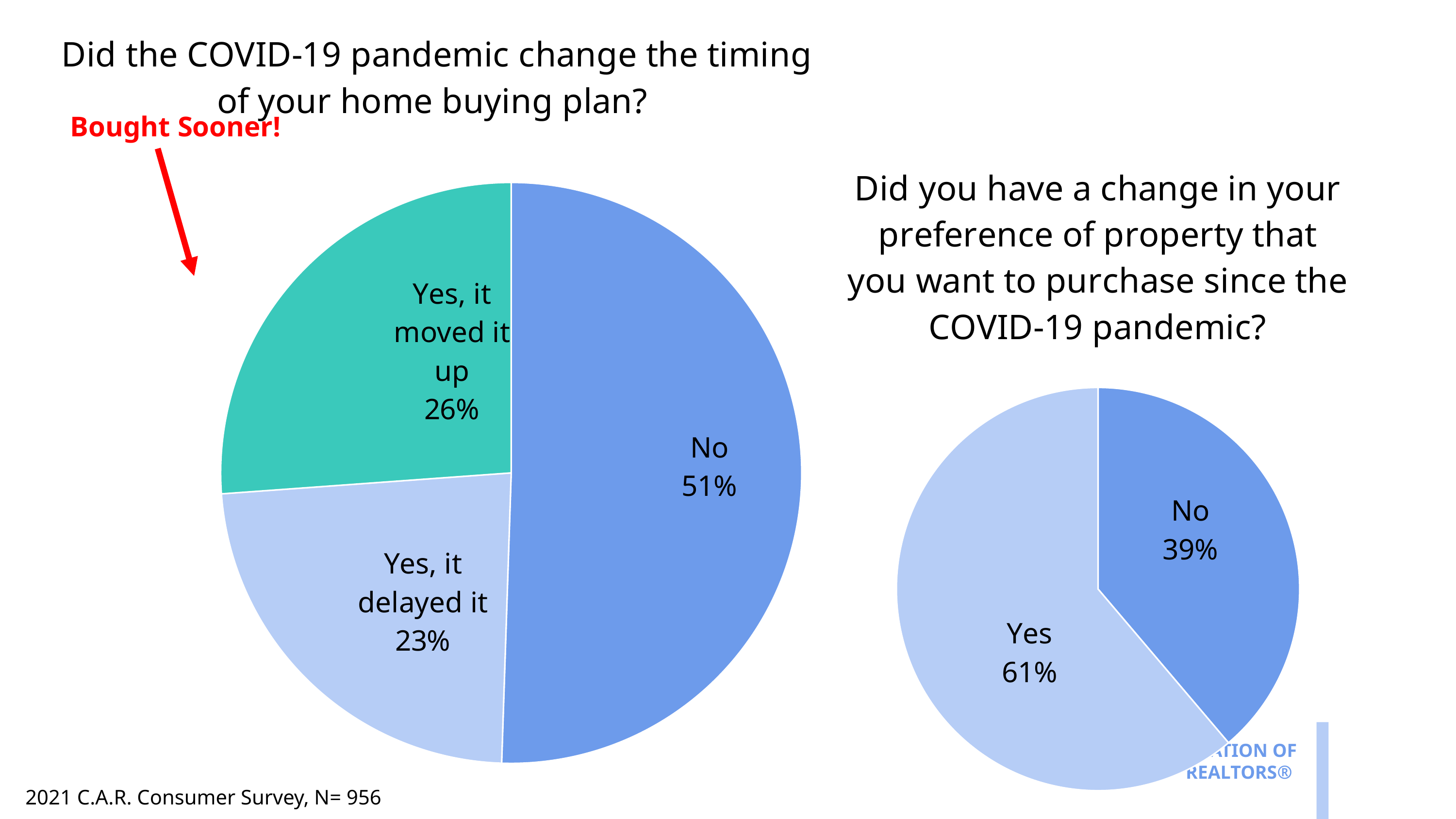
In the right pie chart about a change in property preference, what share of respondents answered "Yes"? 61% In the left pie chart about the timing of the home buying plan, which response has the largest share? No In the right pie chart about a change in property preference, what share of respondents answered "No"? 39% In the right pie chart about a change in property preference, which is larger, "Yes" or "No"? Yes What type of chart is used for both charts on the slide? Pie chart In the left pie chart about the timing of the home buying plan, which response has the smallest share? Yes, it delayed it In the left pie chart about the timing of the home buying plan, what share of respondents answered "No"? 51% In the left pie chart about the timing of the home buying plan, what is the difference in percentage points between "No" and "Yes, it moved it up"? 25 percentage points In the left pie chart about the timing of the home buying plan, how many slices does the pie have? 3 In the left pie chart about the timing of the home buying plan, what share answered "Yes, it delayed it"? 23% In the right pie chart about a change in property preference, what is the difference in percentage points between "Yes" and "No"? 22 percentage points In the left pie chart about the timing of the home buying plan, what share answered "Yes, it moved it up"? 26%